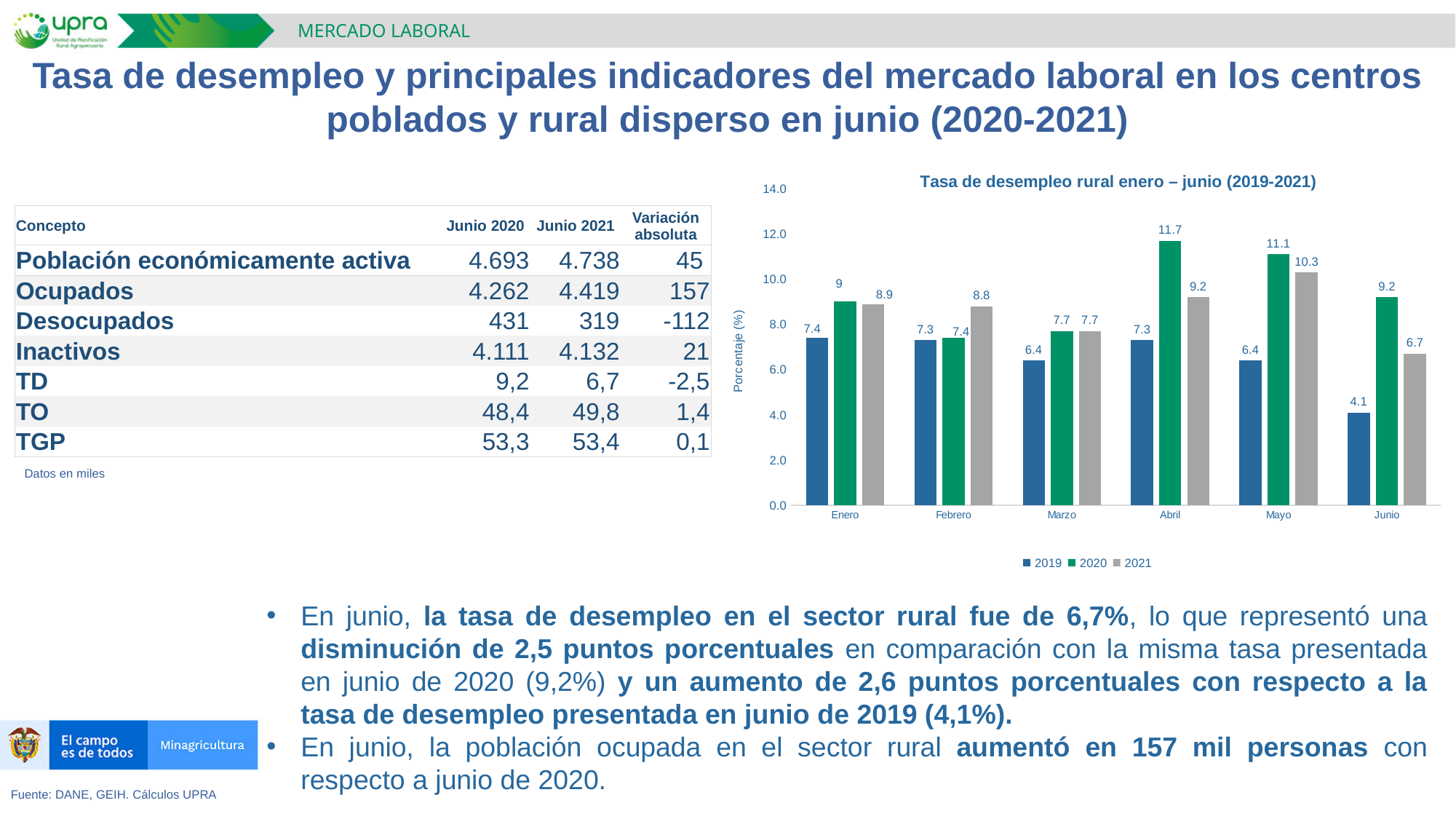
Which month has the lowest value for the 2019 series? Junio What is the difference between the 2020 and 2021 values in Junio? 2.5 What type of chart is shown on the slide? bar chart What is the title of the chart on the slide? Tasa de desempleo rural enero – junio (2019-2021) Is the value for 2021 in Abril greater or less than 8.0? greater Which is larger in Febrero, the value for 2020 or the value for 2021? 2021 How many series does the chart legend list? 3 What is the value for 2020 in Abril? 11.7 What is the value for 2021 in Mayo? 10.3 Which month has the highest value for the 2020 series? Abril How many months are shown on the x axis of the chart? 6 What is the value for 2019 in Junio? 4.1